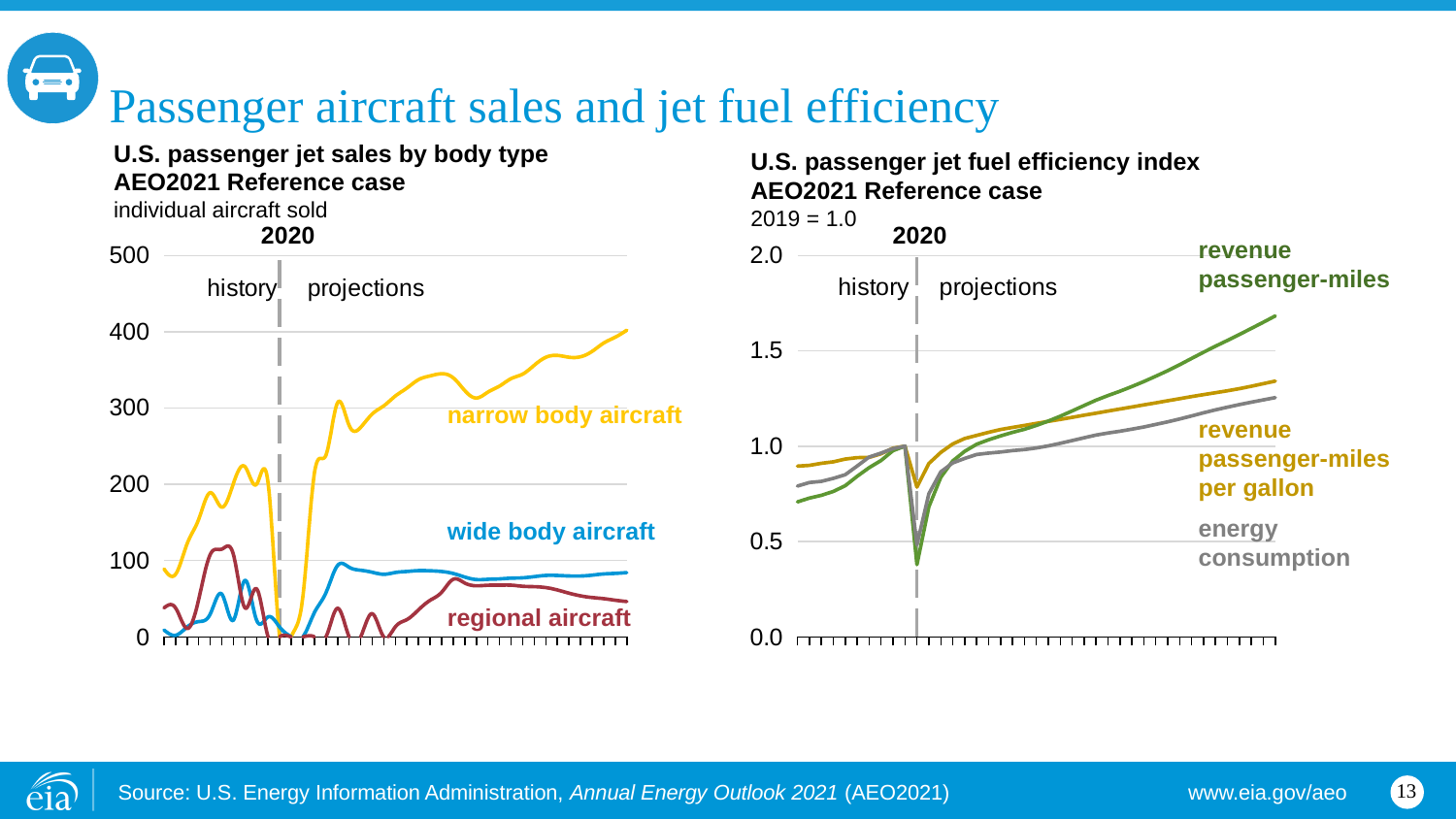
On the 'U.S. passenger jet sales by body type' chart, is the value for wide body aircraft at the end of the projection period greater or less than 100? less What kind of chart is the 'U.S. passenger jet sales by body type' chart on the left? line chart How many series are plotted on the 'U.S. passenger jet sales by body type' chart? 3 On the 'U.S. passenger jet fuel efficiency index' chart, which series is higher at the end of the projection period, revenue passenger-miles or energy consumption? revenue passenger-miles What kind of chart is the 'U.S. passenger jet fuel efficiency index' chart on the right? line chart On the 'U.S. passenger jet sales by body type' chart, is the peak value for narrow body aircraft during the projection period greater or less than 300? greater What is the base year of the index on the 'U.S. passenger jet fuel efficiency index' chart? 2019 = 1.0 On the 'U.S. passenger jet sales by body type' chart, which series is higher at the end of the projection period, narrow body aircraft or regional aircraft? narrow body aircraft On the 'U.S. passenger jet fuel efficiency index' chart, does revenue passenger-miles rise or fall over the projection period? rise How many series are plotted on the 'U.S. passenger jet fuel efficiency index' chart? 3 On the 'U.S. passenger jet fuel efficiency index' chart, is the value for energy consumption at the end of the projection period greater or less than 1.5? less